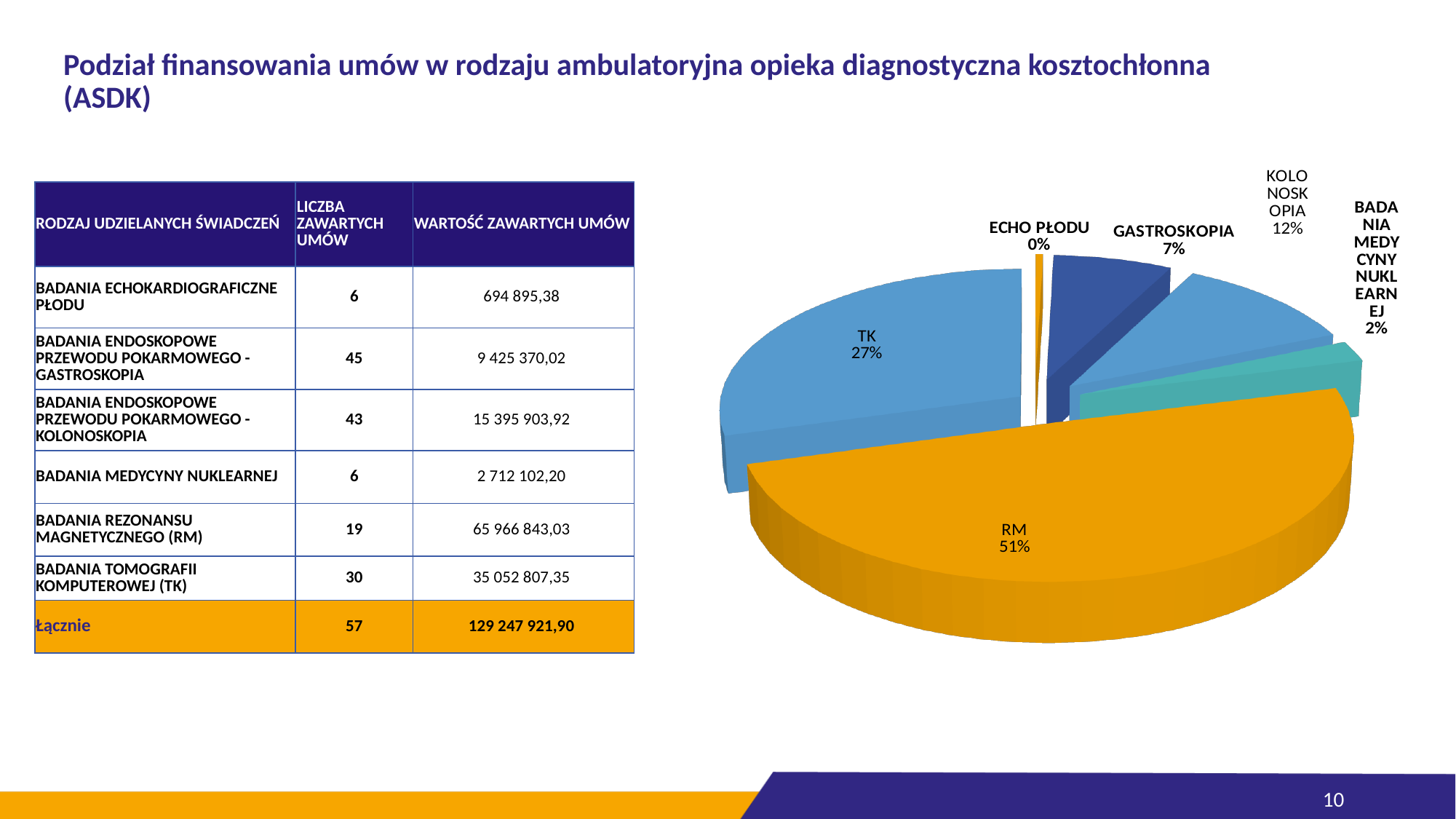
What share of the pie does ECHO PŁODU have? 0% Which slice is larger, KOLONOSKOPIA or GASTROSKOPIA? KOLONOSKOPIA What share of the pie does TK have? 27% Which slice of the pie chart is the smallest? ECHO PŁODU How many slices does the pie chart have? 6 What is the difference in percentage points between the RM slice and the TK slice? 24 What share of the pie does BADANIA MEDYCYNY NUKLEARNEJ have? 2% Which slice of the pie chart is the largest? RM What kind of chart is shown on the slide? pie chart